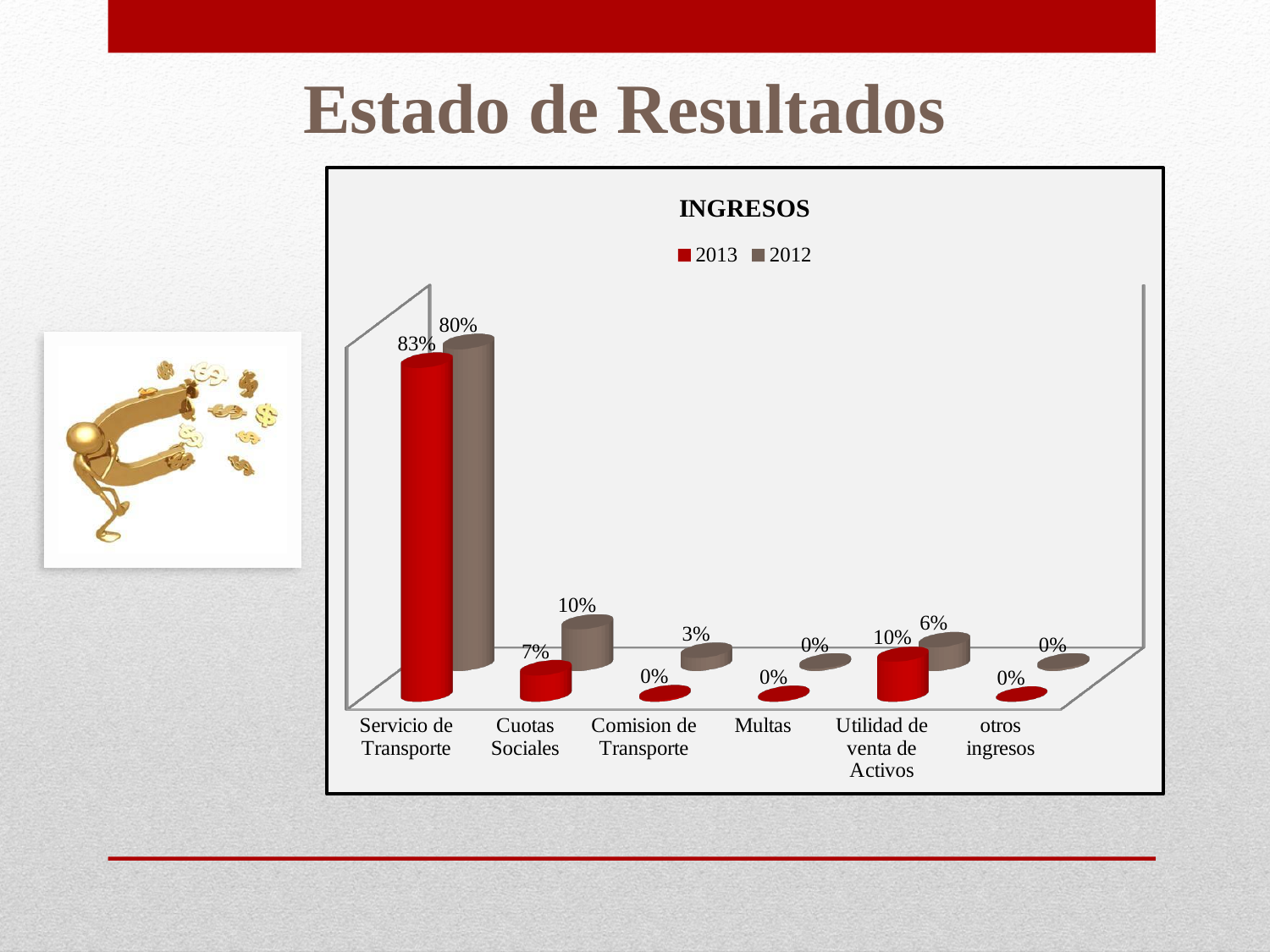
Which colour represents the 2013 series in the INGRESOS chart? Red What is the 2013 value for Servicio de Transporte in the INGRESOS chart? 83% What is the 2012 value for Comision de Transporte in the INGRESOS chart? 3% What is the difference between the 2012 and 2013 values for Cuotas Sociales in the INGRESOS chart? 3% How many categories are shown on the x axis of the INGRESOS chart? 6 How many series does the legend of the INGRESOS chart list? 2 What kind of chart is the INGRESOS chart? Bar chart What is the difference between the 2013 and 2012 values for Servicio de Transporte in the INGRESOS chart? 3% Which category has the highest 2013 value in the INGRESOS chart? Servicio de Transporte In the INGRESOS chart, which is larger for Utilidad de venta de Activos: the 2013 value or the 2012 value? 2013 What is the 2012 value for Cuotas Sociales in the INGRESOS chart? 10% What is the 2013 value for Utilidad de venta de Activos in the INGRESOS chart? 10%